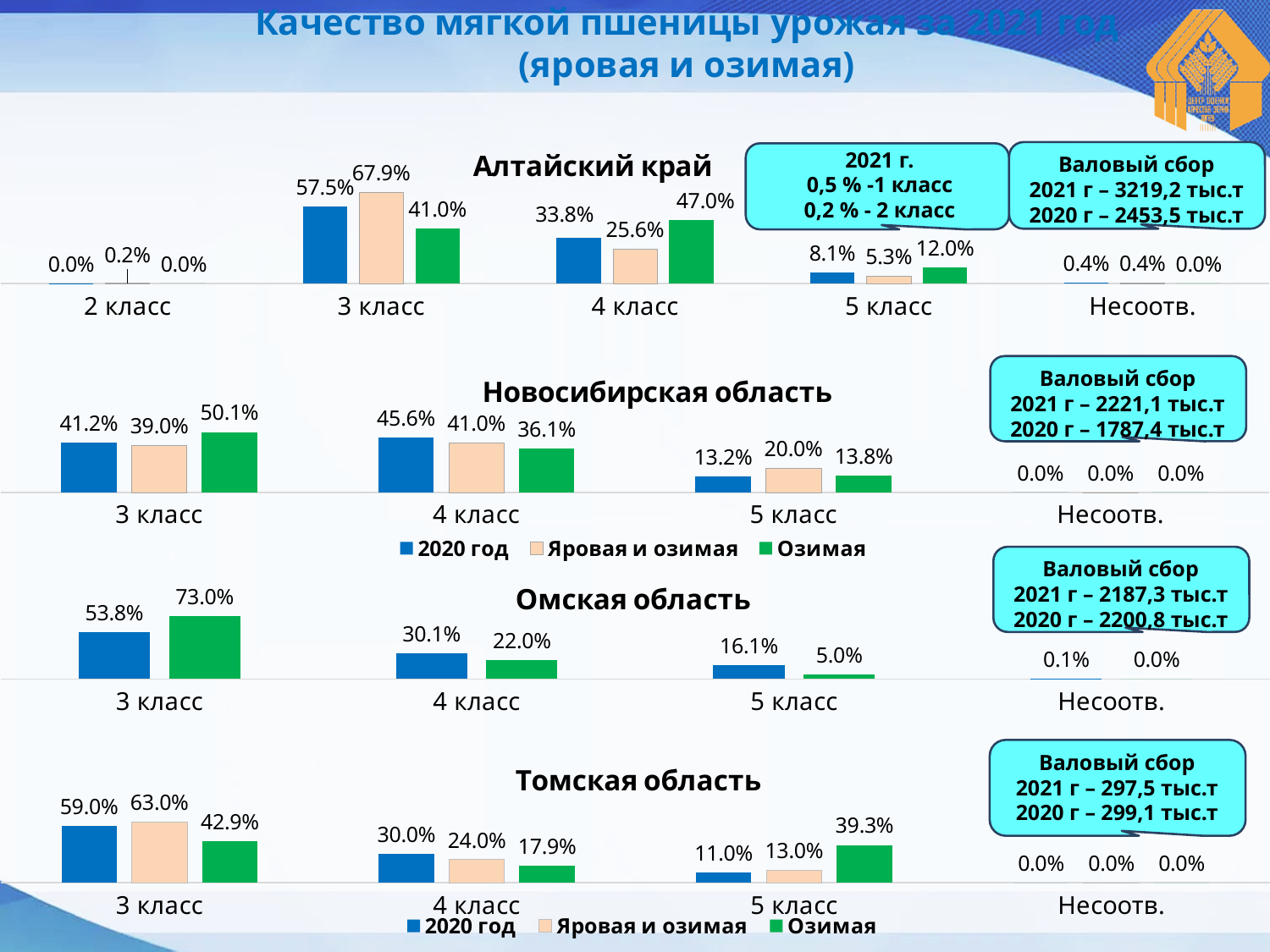
In the Новосибирская область chart, what is the Озимая value for 3 класс? 50.1% In the Алтайский край chart, how much higher is the Яровая и озимая value than the 2020 год value for 3 класс? 10.4 percentage points How many categories are shown on the x axis of the Алтайский край chart? 5 In the Томская область chart, for 3 класс, which is larger: the 2020 год value or the Озимая value? 2020 год How many series does the legend below the Новосибирская область chart list? 3 In the Алтайский край chart, what is the value for 2020 год in the 3 класс category? 57.5% What type of chart is the Томская область chart? Bar chart In the Томская область chart, what is the Озимая value for 5 класс? 39.3% In the Алтайский край chart, what is the Озимая value for 4 класс? 47.0% In the Новосибирская область chart, which category has the highest Озимая value? 3 класс